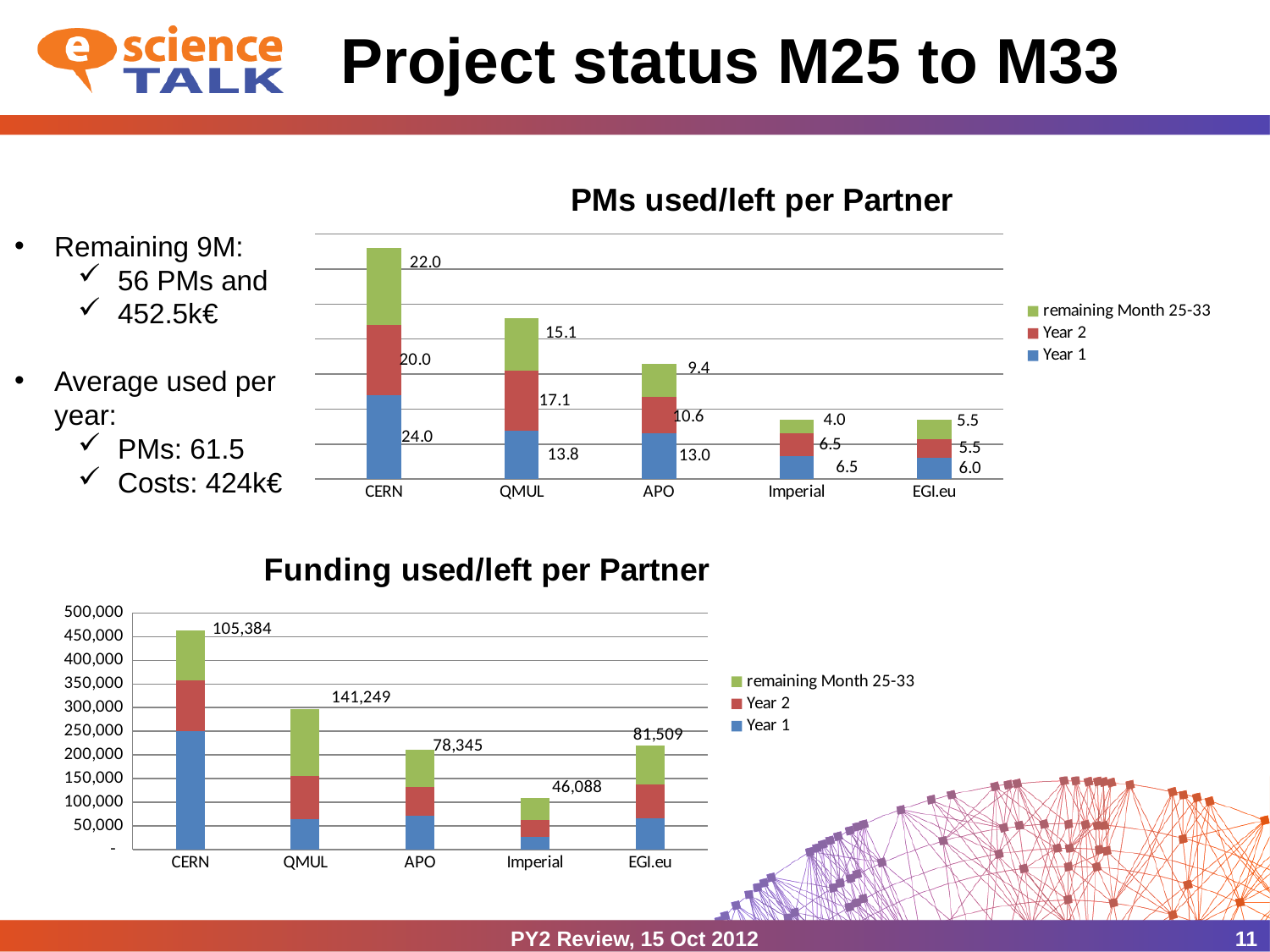
In the 'PMs used/left per Partner' chart, what is the remaining Month 25-33 value for QMUL? 15.1 In the 'Funding used/left per Partner' chart, how many series does the legend list? 3 In the 'PMs used/left per Partner' chart, what is the Year 2 value for APO? 10.6 In the 'PMs used/left per Partner' chart, what is the total of the stacked bar for Imperial? 17.0 In the 'Funding used/left per Partner' chart, is the total stacked bar for CERN greater or less than 400,000? greater In the 'PMs used/left per Partner' chart, which partner has the highest remaining Month 25-33 value? CERN What kind of chart is the 'Funding used/left per Partner' chart? Stacked bar chart In the 'PMs used/left per Partner' chart, how many partners are shown on the x axis? 5 In the 'Funding used/left per Partner' chart, what is the remaining Month 25-33 value for QMUL? 141,249 In the 'PMs used/left per Partner' chart, what is the difference between the Year 1 values for CERN and QMUL? 10.2 In the 'PMs used/left per Partner' chart, what is the Year 1 value for CERN? 24.0 In the 'Funding used/left per Partner' chart, which partner has the lowest remaining Month 25-33 value? Imperial